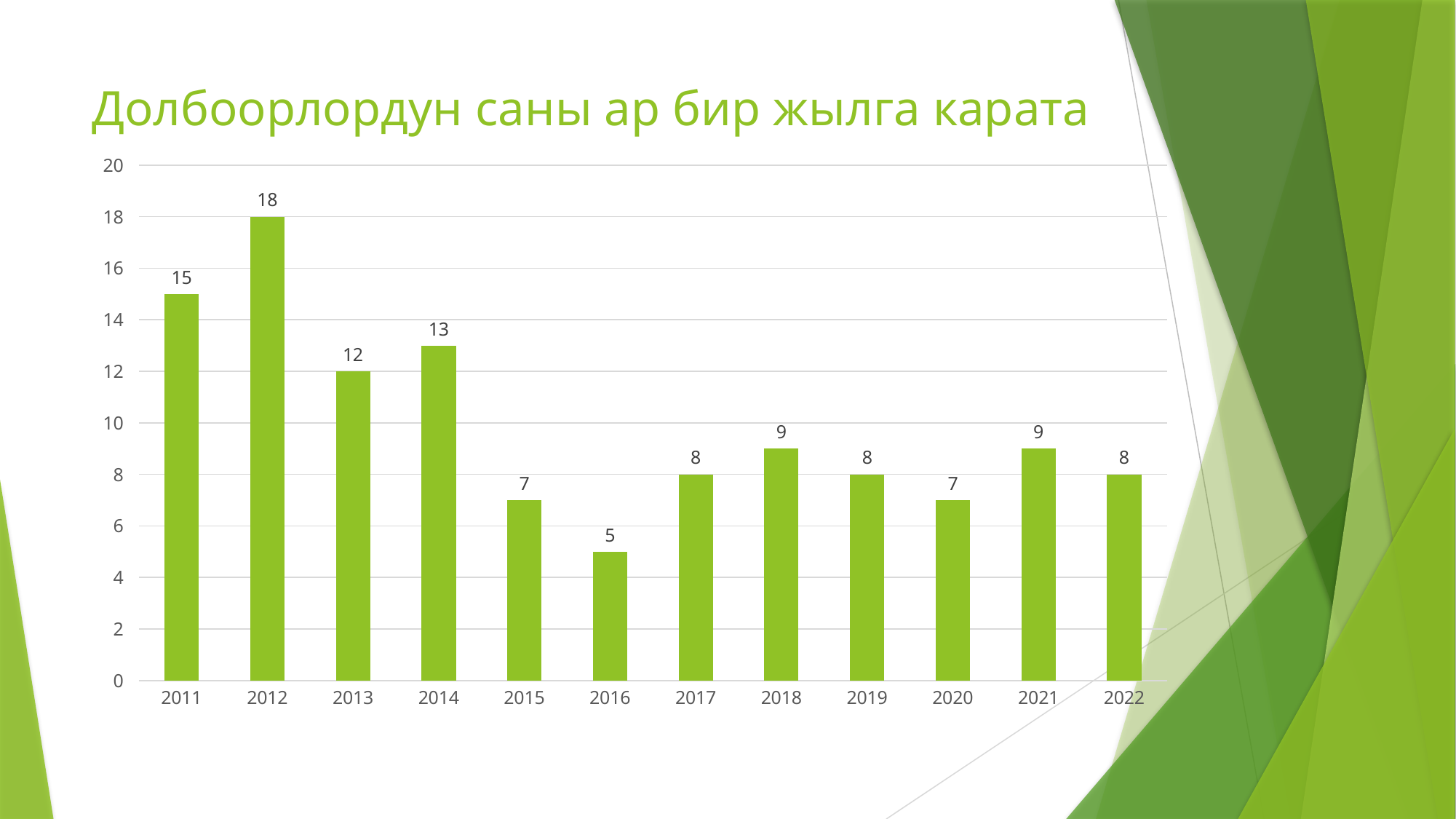
What is the value for 2016? 5 What is the difference between the values for 2012 and 2016? 13 What is the difference between the values for 2011 and 2014? 2 Which is larger, the value for 2013 or the value for 2018? 2013 What kind of chart is shown on the slide? bar chart How many years are shown on the x axis? 12 Which year has the highest value? 2012 Is the value for 2011 greater or less than 10? greater Which year has the lowest value? 2016 What is the value for 2012? 18 What is the title of the chart? Долбоорлордун саны ар бир жылга карата What is the value for 2022? 8